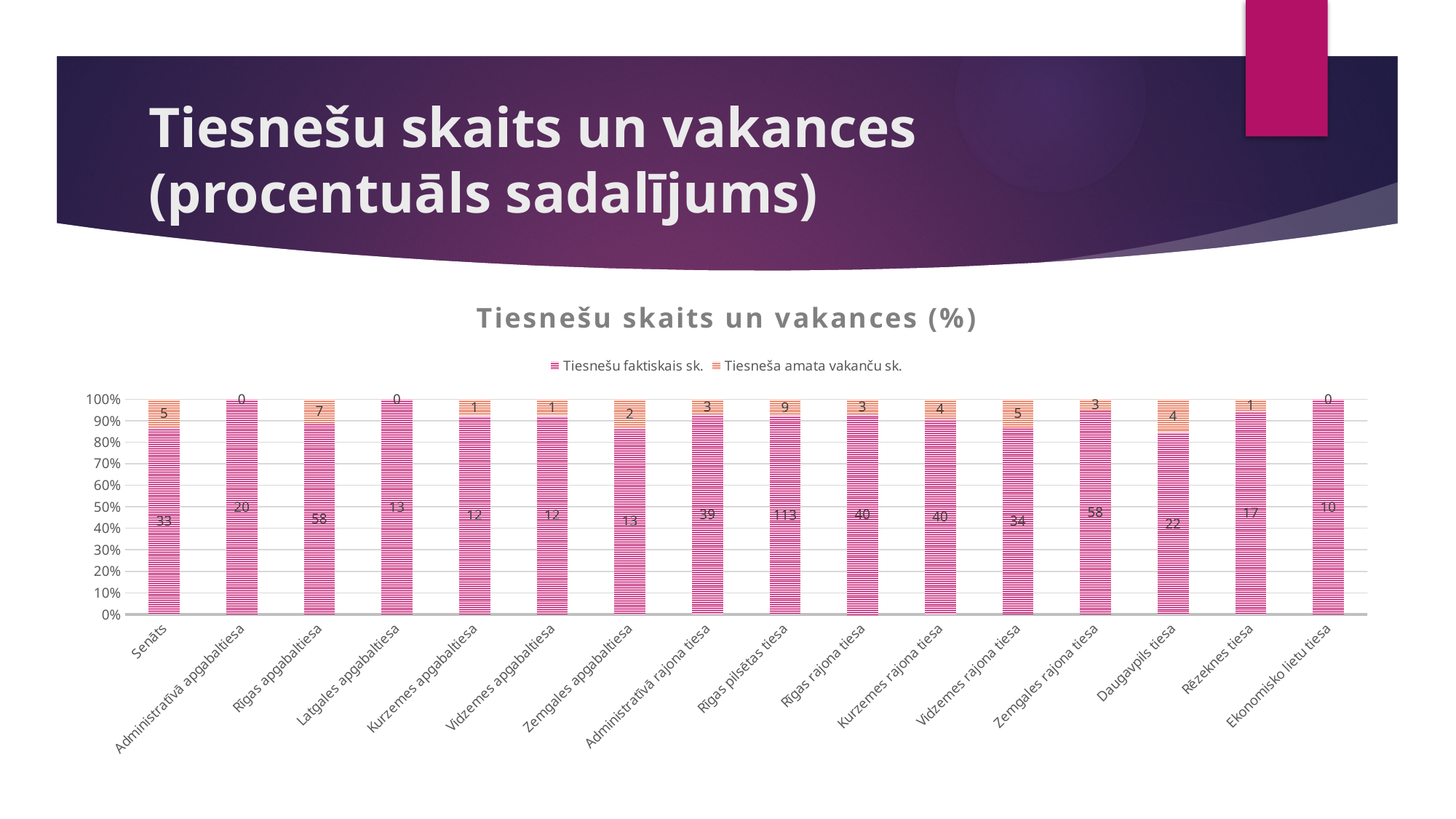
What is the total of the two values labelled on the Senāts bar? 38 How many categories are shown on the x axis? 16 How many series does the legend list? 2 What is the value of Tiesnešu faktiskais sk. for Rīgas pilsētas tiesa? 113 Which has a larger Tiesnešu faktiskais sk. value, Administratīvā rajona tiesa or Kurzemes rajona tiesa? Kurzemes rajona tiesa Which category has the highest value for Tiesnešu faktiskais sk.? Rīgas pilsētas tiesa What is the value of Tiesneša amata vakanču sk. for Rīgas apgabaltiesa? 7 Which category has the lowest value for Tiesnešu faktiskais sk.? Ekonomisko lietu tiesa What is the difference between the Tiesnešu faktiskais sk. values for Rīgas apgabaltiesa and Daugavpils tiesa? 36 What is the value of Tiesnešu faktiskais sk. for Senāts? 33 What kind of chart is shown? Stacked bar chart Which has a larger Tiesneša amata vakanču sk. value, Senāts or Vidzemes rajona tiesa? They are equal (5)